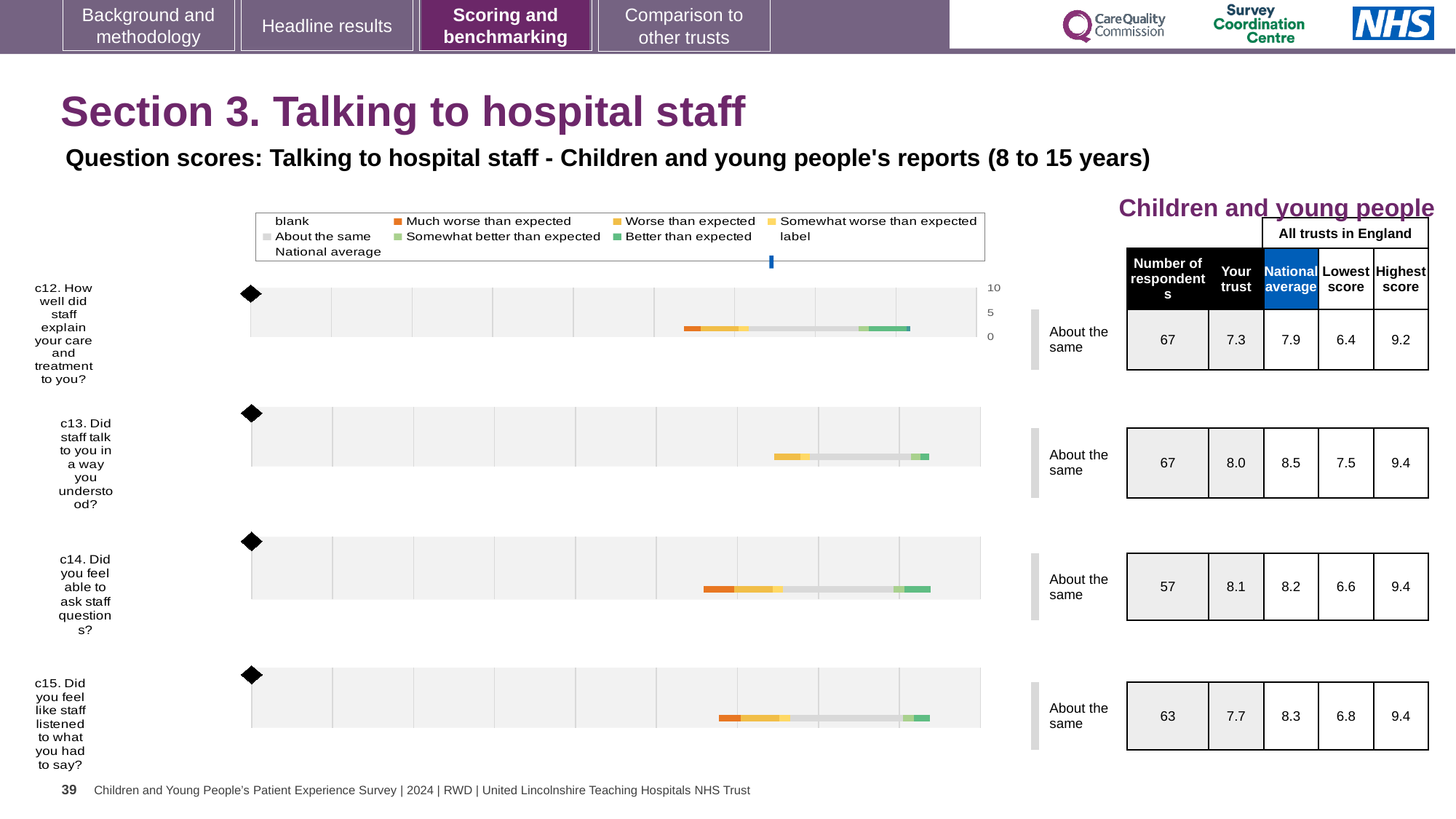
For the c12 chart (How well did staff explain your care and treatment to you?), what is the 'Your trust' score shown in the table? 7.3 For the c13 chart, which is larger: the 'Your trust' score or the national average? National average Which of the four questions has the highest 'Your trust' score? c14 For the c12 chart, what is the difference between the highest score and the lowest score across all trusts in England? 2.8 How many question charts (c12 to c15) are shown on the slide? 4 How many entries does the chart legend list? 9 For the c15 chart (Did you feel like staff listened to what you had to say?), what benchmark category is the trust placed in? About the same For the c13 chart (Did staff talk to you in a way you understood?), what is the national average score? 8.5 Which of the four questions has the lowest 'Your trust' score? c12 For the c14 chart (Did you feel able to ask staff questions?), how many respondents are shown? 57 For the c12 chart, is the 'Your trust' score greater or less than 5? greater What kind of chart is used to show the benchmark bands for question c12? bar chart